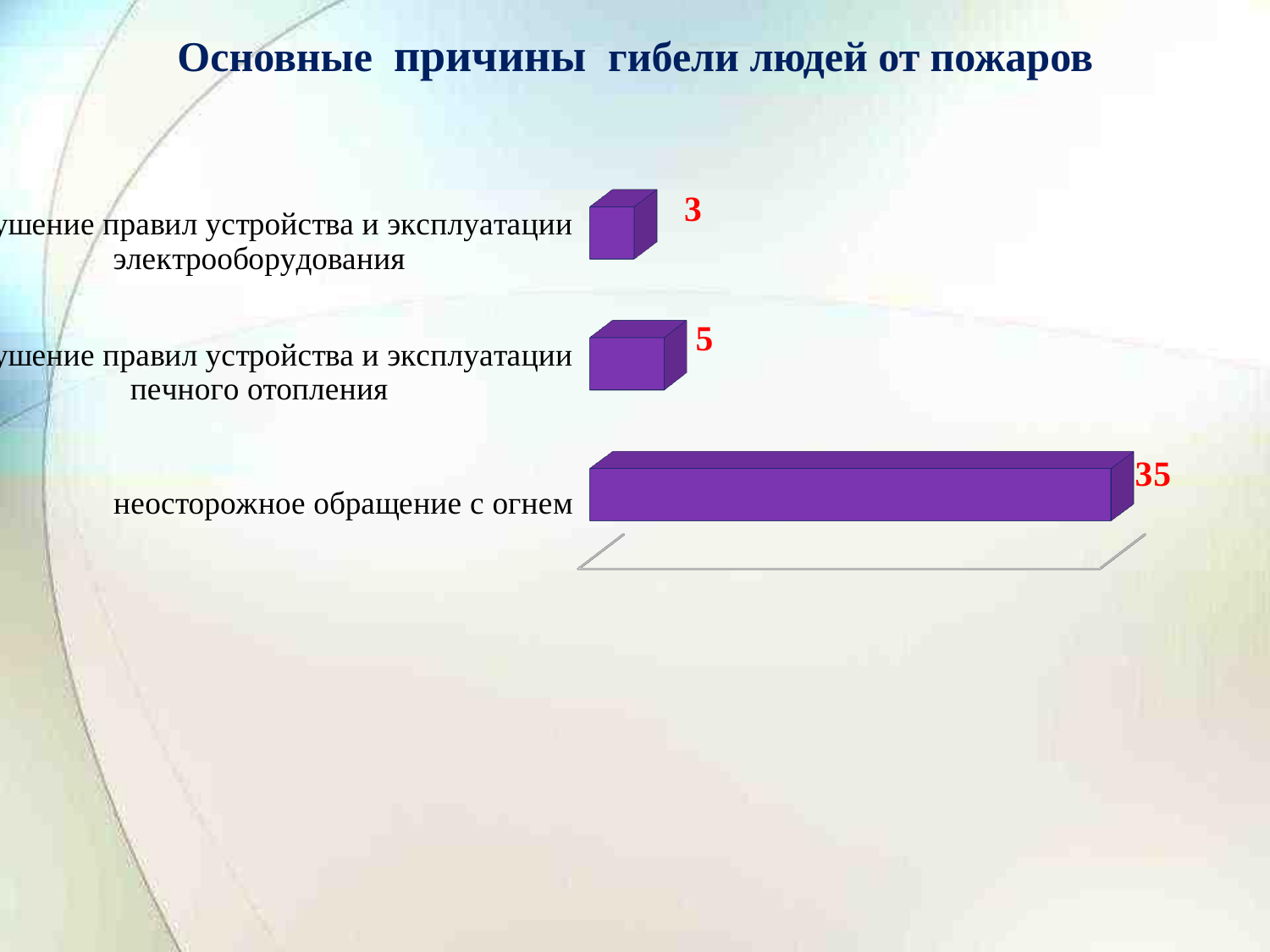
Which category has the lowest value? нарушение правил устройства и эксплуатации электрооборудования What colour are the bars in the chart? purple How many categories are shown in the chart? 3 What value is shown for the category about "электрооборудования" (electrical equipment)? 3 Which category has the highest value? неосторожное обращение с огнем What kind of chart is shown on the slide? bar chart What is the difference between the values for the stove heating ("печного отопления") category and the electrical equipment ("электрооборудования") category? 2 Which is larger: the value for the stove heating ("печного отопления") category or the electrical equipment ("электрооборудования") category? печного отопления What value is shown for the category about "печного отопления" (stove heating)? 5 What is the difference between the value for "неосторожное обращение с огнем" and the value for the stove heating ("печного отопления") category? 30 What value is shown for "неосторожное обращение с огнем"? 35 What is the title of the slide? Основные причины гибели людей от пожаров